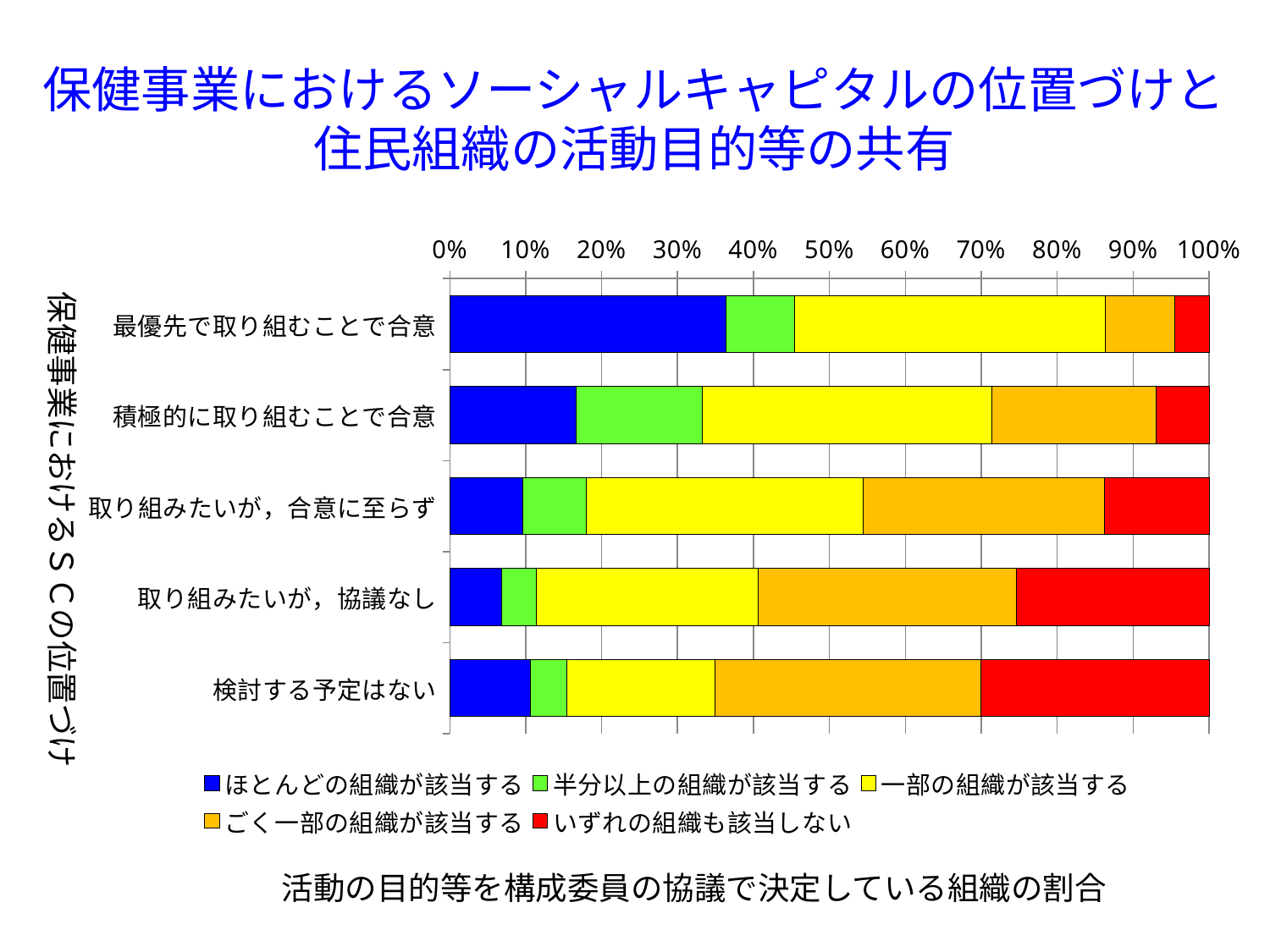
Is the blue (ほとんどの組織が該当する) segment for 取り組みたいが，協議なし greater or less than 10%? less Going down the categories from 最優先で取り組むことで合意 to 検討する予定はない, does the red (いずれの組織も該当しない) segment grow or shrink? grows What is the highest value shown on the horizontal axis? 100% How many series does the legend list? 5 Which has a larger blue (ほとんどの組織が該当する) segment: 最優先で取り組むことで合意 or 積極的に取り組むことで合意? 最優先で取り組むことで合意 Which category has the largest blue (ほとんどの組織が該当する) segment? 最優先で取り組むことで合意 How many categories are plotted on the vertical axis of the chart? 5 Is the blue (ほとんどの組織が該当する) segment for 最優先で取り組むことで合意 greater or less than 30%? greater What is the first entry in the chart legend? ほとんどの組織が該当する What kind of chart is shown on the slide? Stacked bar chart Which category has the largest red (いずれの組織も該当しない) segment? 検討する予定はない Is the red (いずれの組織も該当しない) segment for 検討する予定はない greater or less than 20%? greater